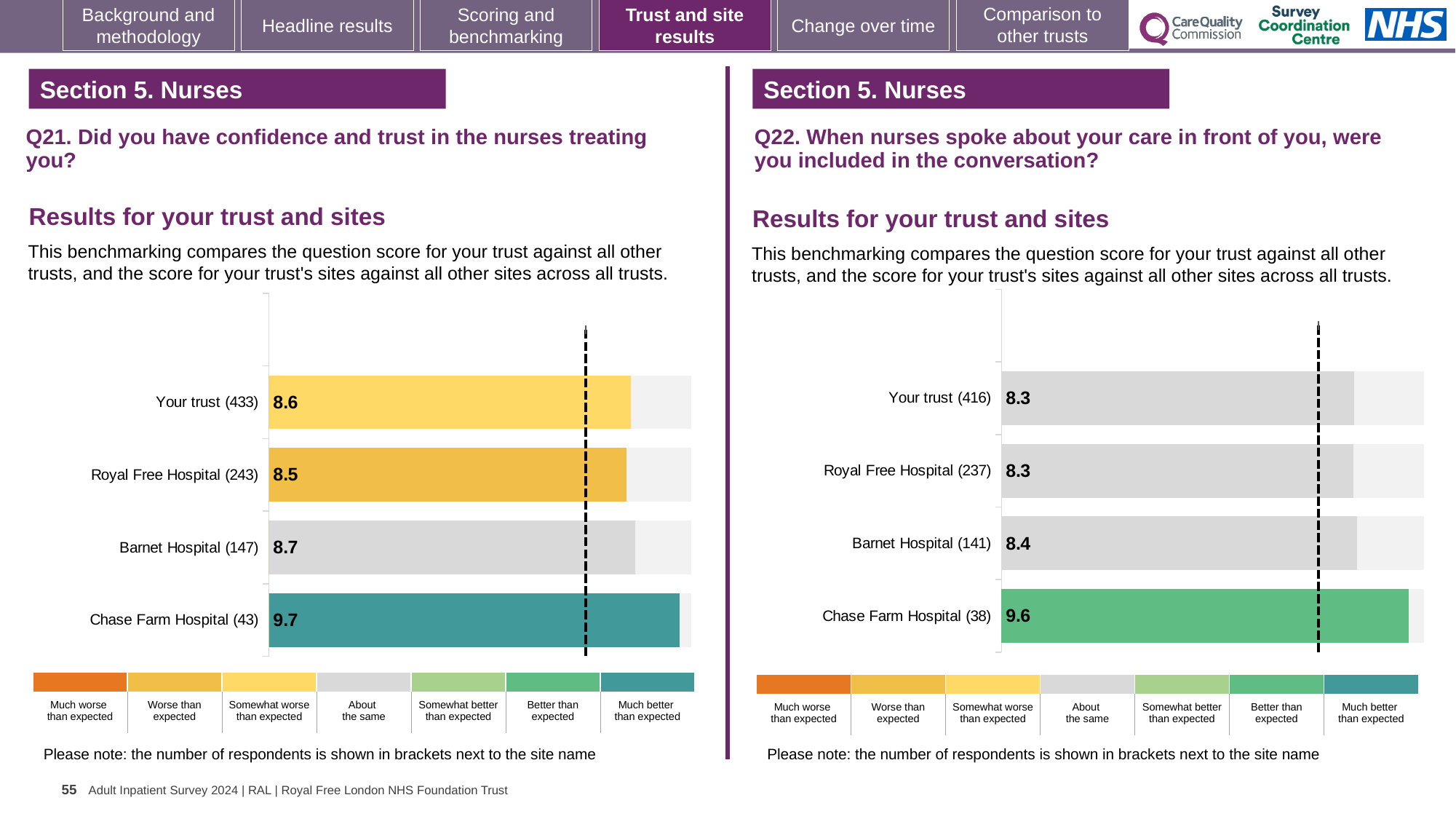
In the Q21 chart, what is the difference between the scores for Chase Farm Hospital and Your trust? 1.1 In the Q21 chart, what is the score for Your trust? 8.6 In the Q21 chart, what is the score for Chase Farm Hospital? 9.7 What kind of chart is used for the Q21 results? Bar chart In the Q22 chart, what is the score for Barnet Hospital? 8.4 How many bars are plotted in the Q22 chart? 4 In the Q21 chart, which site or trust has the highest score? Chase Farm Hospital In the Q21 chart, which has the higher score, Barnet Hospital or Royal Free Hospital? Barnet Hospital In the Q22 chart, which site or trust has the highest score? Chase Farm Hospital In the Q22 chart, what is the score for Royal Free Hospital? 8.3 In the Q22 chart, what is the difference between the scores for Chase Farm Hospital and Barnet Hospital? 1.2 In the Q21 chart, which site or trust has the lowest score? Royal Free Hospital